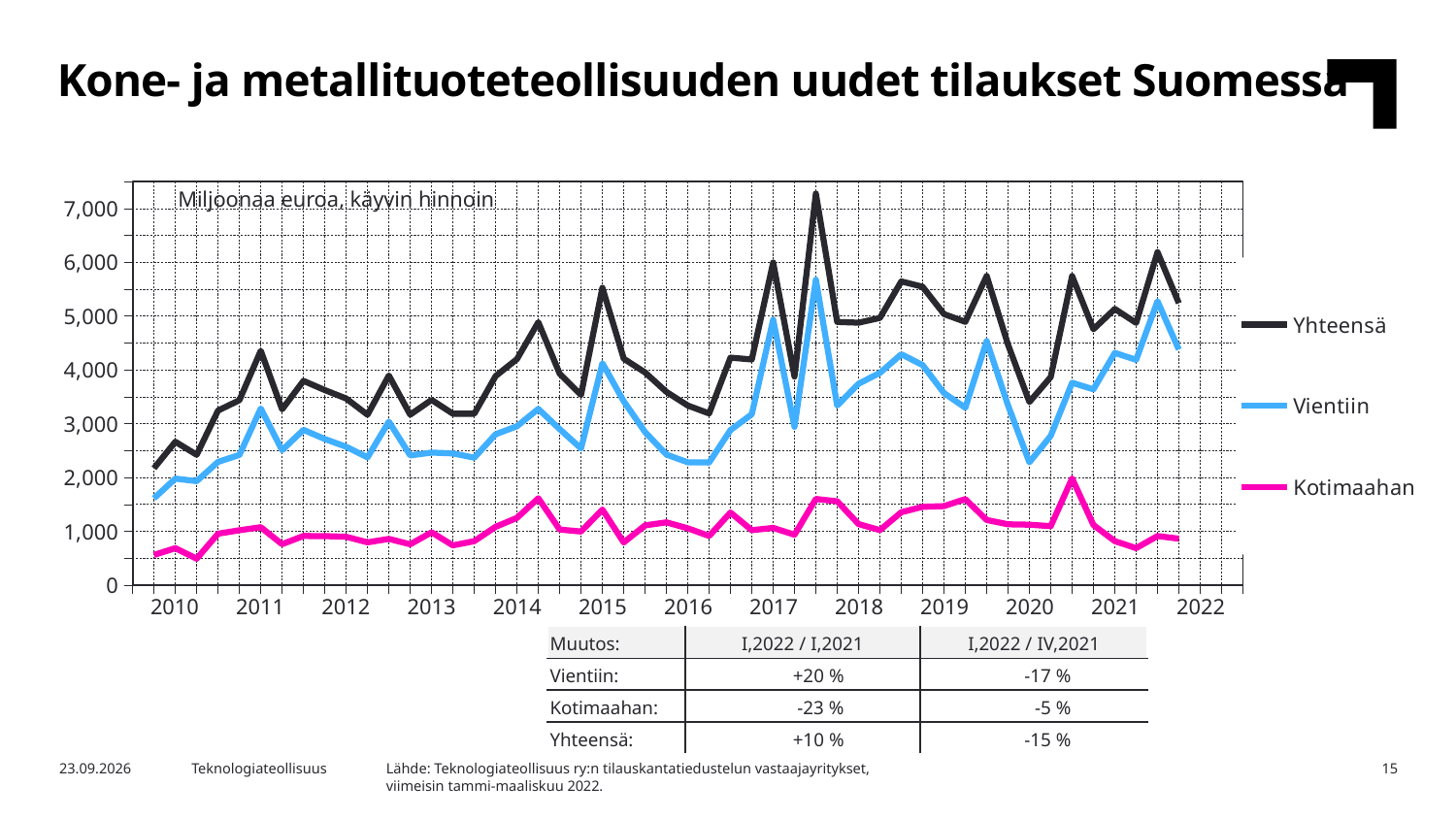
How many series does the chart legend list? 3 Is the value for Kotimaahan at the start of 2010 greater or less than 1,000? less Which series has the lowest values throughout the chart? Kotimaahan Does the Vientiin series rise or fall from its low point in 2020 to the end of 2021? rise What colour is the Kotimaahan line? Pink Is the value for Yhteensä at the start of 2010 greater or less than 3,000? less Which series is larger in 2018, Vientiin or Kotimaahan? Vientiin What kind of chart is shown on the slide? Line chart What unit is stated inside the chart area? Miljoonaa euroa, käyvin hinnoin Is the value for Vientiin at the start of 2010 greater or less than 2,000? less Which series has the highest values throughout the chart? Yhteensä